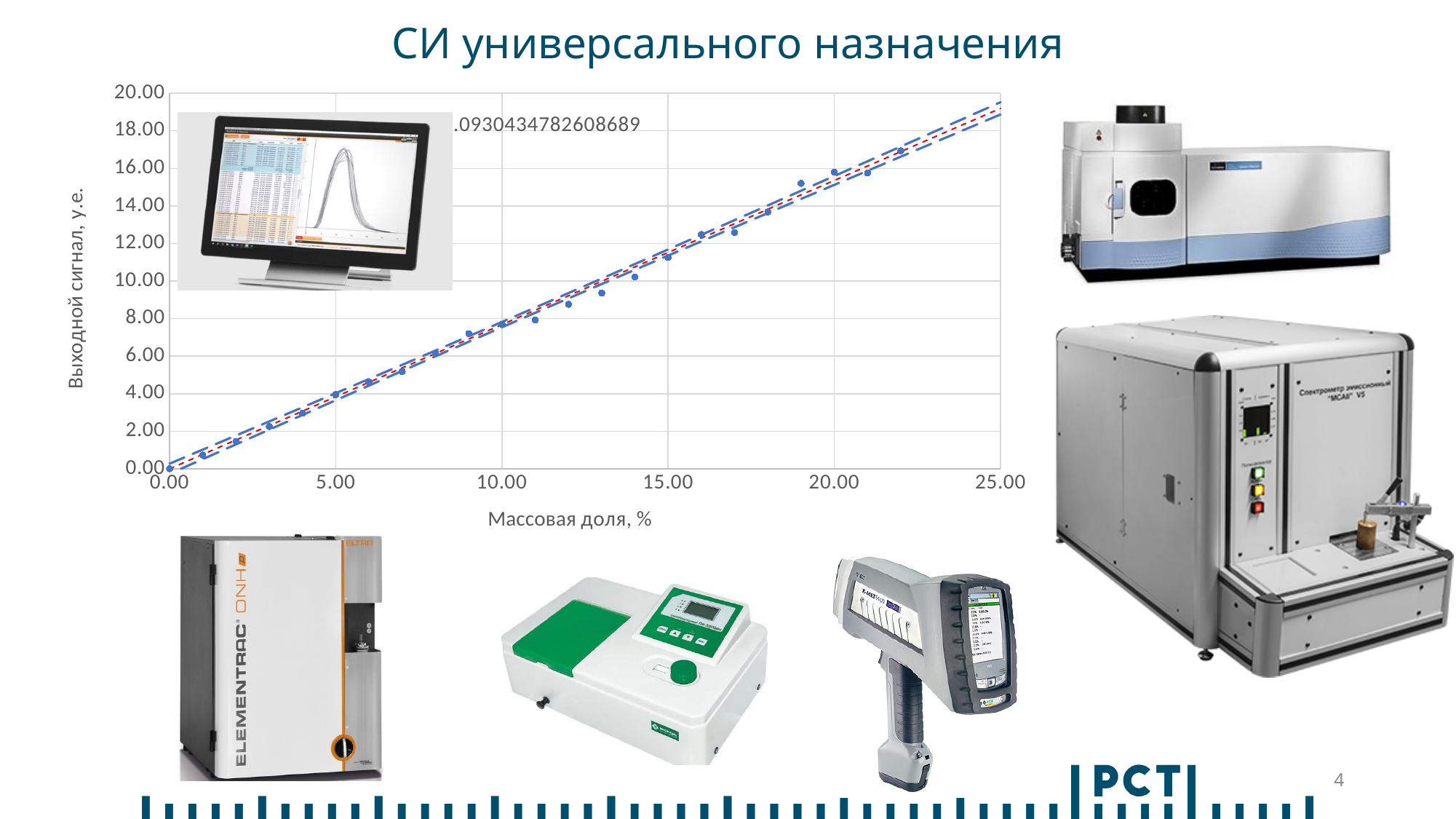
Is the output signal value at a mass fraction of 15.00% greater or less than 10.00? greater Is the output signal value at a mass fraction of 25.00% greater or less than 18.00? greater What is the title of the y axis of the chart? Выходной сигнал, у.е. What is the title of the x axis of the chart? Массовая доля, % Is the output signal value at a mass fraction of 20.00% greater or less than 14.00? greater What kind of chart is shown on the slide? scatter chart Do the plotted values rise or fall as the mass fraction (Массовая доля, %) increases along the x axis? rise Which has the larger output signal: the point at a mass fraction of 22.00% or the point at 12.00%? 22.00%